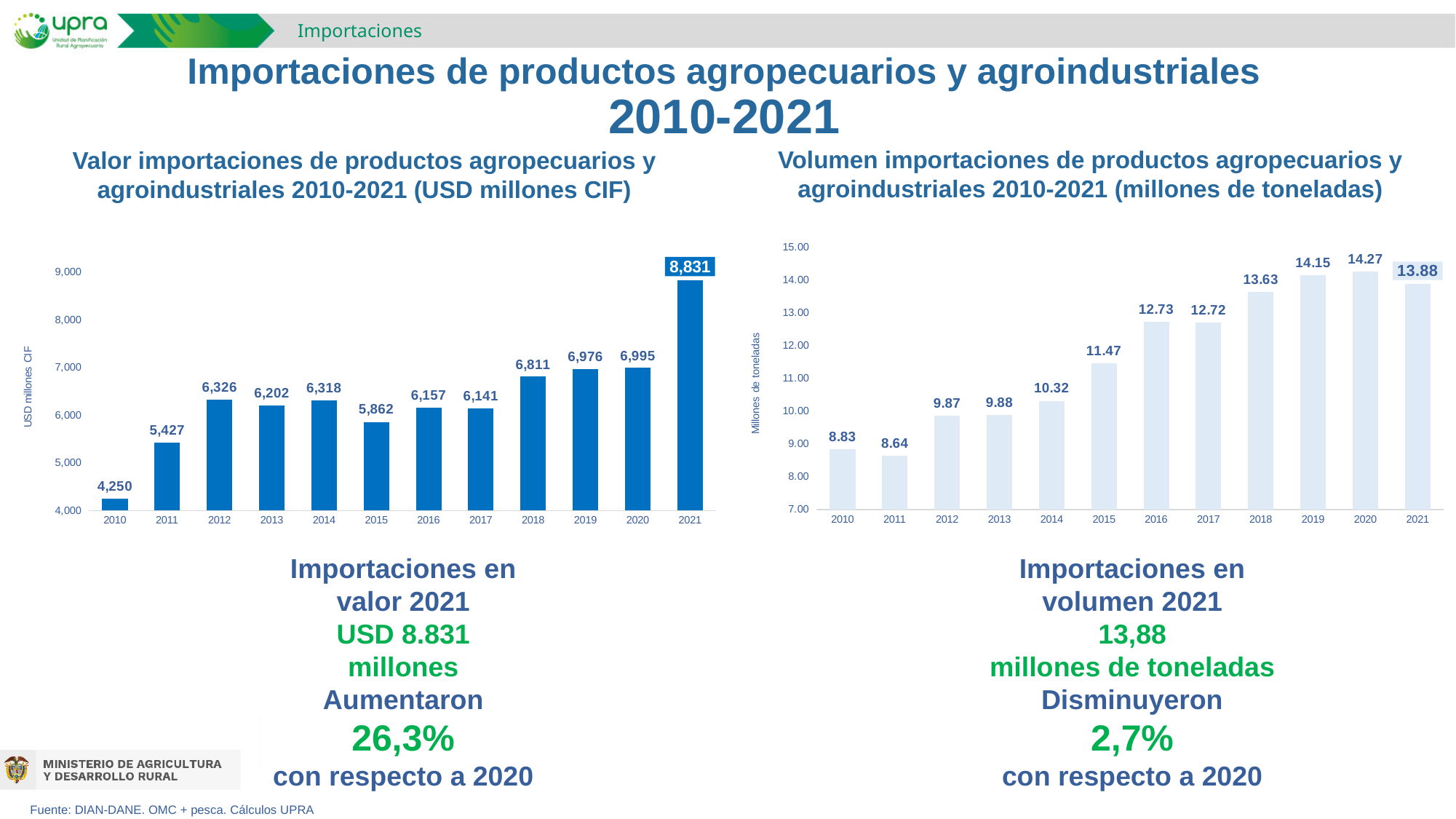
In the right chart (Volumen importaciones, millones de toneladas), do the values generally rise or fall from 2010 to 2020? Rise In the left chart (Valor importaciones, USD millones CIF), what is the difference between the 2021 and 2020 values? 1,836 In the left chart (Valor importaciones, USD millones CIF), how many years are plotted? 12 In the right chart (Volumen importaciones, millones de toneladas), is the value for 2018 greater or less than 13.00? greater In the left chart (Valor importaciones, USD millones CIF), what is the value for 2021? 8,831 In the left chart (Valor importaciones, USD millones CIF), which is larger, the value for 2012 or the value for 2015? 2012 In the right chart (Volumen importaciones, millones de toneladas), what is the value for 2015? 11.47 What kind of chart is the left chart (Valor importaciones, USD millones CIF)? Bar chart In the right chart (Volumen importaciones, millones de toneladas), which year has the highest value? 2020 In the left chart (Valor importaciones, USD millones CIF), which year has the lowest value? 2010 In the right chart (Volumen importaciones, millones de toneladas), what is the difference between the 2020 and 2021 values? 0.39 What is the y-axis label of the right chart (Volumen importaciones)? Millones de toneladas